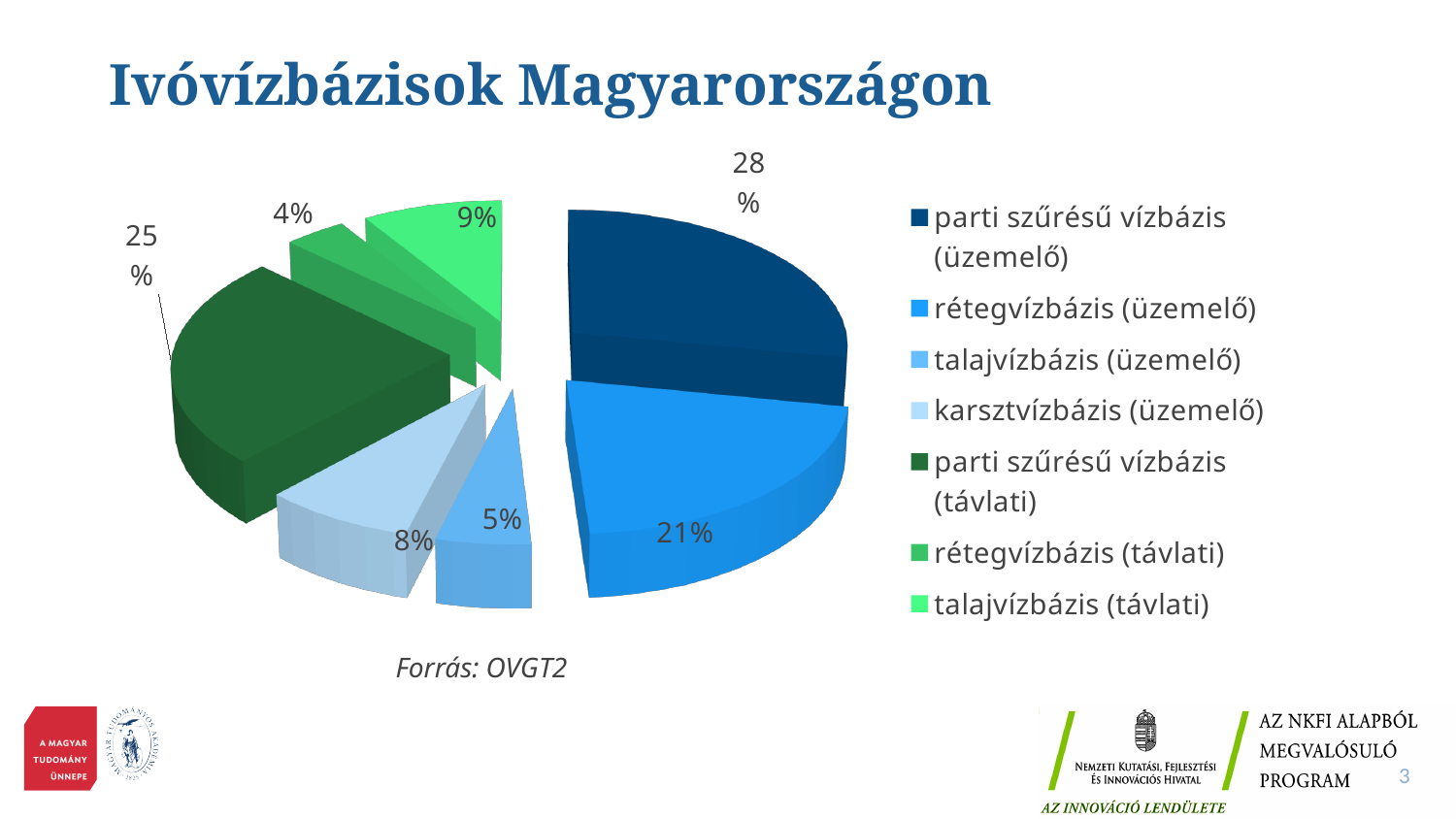
How many entries does the legend list? 7 What kind of chart is shown on the slide? pie chart What is the title of the chart slide? Ivóvízbázisok Magyarországon Which is larger, the share of talajvízbázis (távlati) or talajvízbázis (üzemelő)? talajvízbázis (távlati) What is the difference between the shares of parti szűrésű vízbázis (üzemelő) and rétegvízbázis (üzemelő)? 7% What share of the pie is parti szűrésű vízbázis (távlati)? 25% Which category has the smallest slice of the pie? rétegvízbázis (távlati) How many slices does the pie chart have? 7 Which category has the largest slice of the pie? parti szűrésű vízbázis (üzemelő) What share of the pie is parti szűrésű vízbázis (üzemelő)? 28% What share of the pie is karsztvízbázis (üzemelő)? 8%